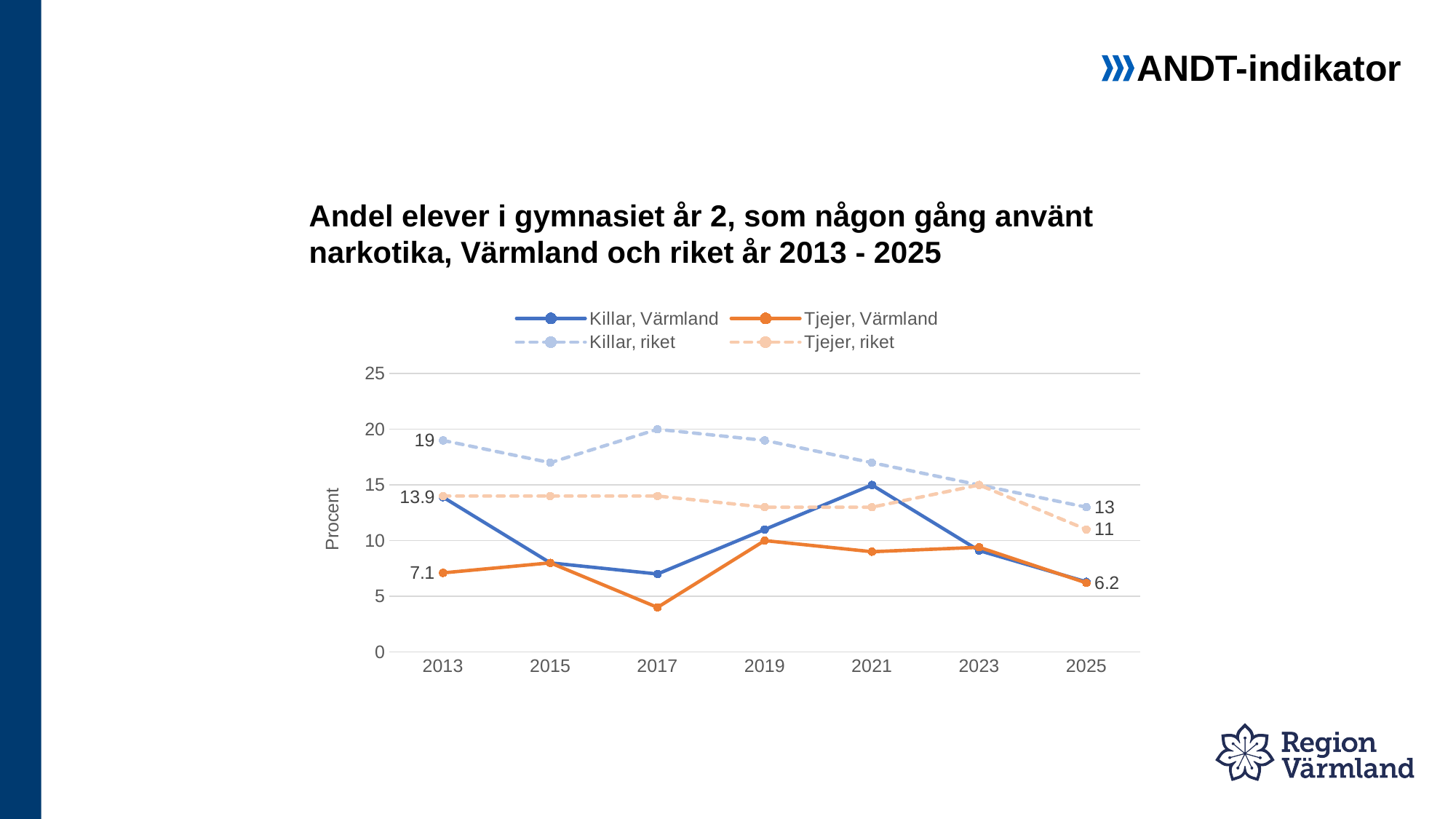
What kind of chart is shown on the slide? line chart How many years are shown on the x axis? 7 In 2021, which is larger: Killar, Värmland or Tjejer, Värmland? Killar, Värmland Is the value for Tjejer, Värmland in 2017 greater or less than 5? less What is the value for Tjejer, Värmland in 2013? 7.1 What is the value for Killar, Värmland in 2013? 13.9 What is the value for Tjejer, riket in 2025? 11 What is the value for Killar, riket in 2025? 13 What is the label on the y axis? Procent How many series does the legend list? 4 What is the value for Killar, riket in 2013? 19 What is the difference between Killar, riket and Killar, Värmland in 2013? 5.1